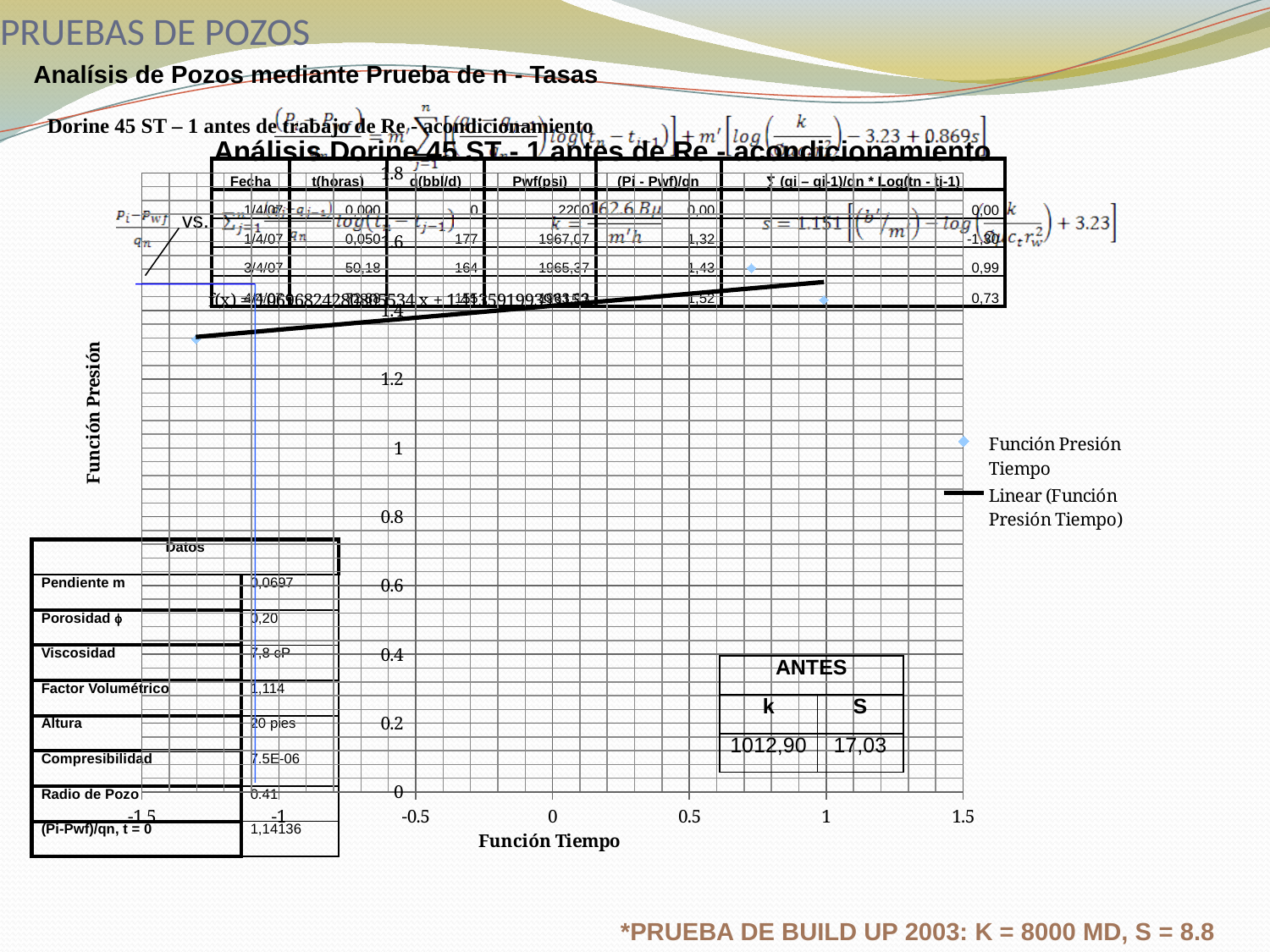
How many entries does the chart legend list? 2 Does the linear trendline rise or fall as Función Tiempo increases? rise What is the name of the data series shown with diamond markers in the legend? Función Presión Tiempo What is the title of the chart? Análisis Dorine 45 ST - 1 antes de Re - acondicionamiento Is the Función Presión value of the data point near Función Tiempo 0.7 greater or less than 1.4? greater Is the Función Presión value of the data point near Función Tiempo -1.3 greater or less than 1.2? greater Is the Función Presión value of the data point near Función Tiempo 1.0 greater or less than 1.2? greater What kind of chart is shown on the slide? scatter chart